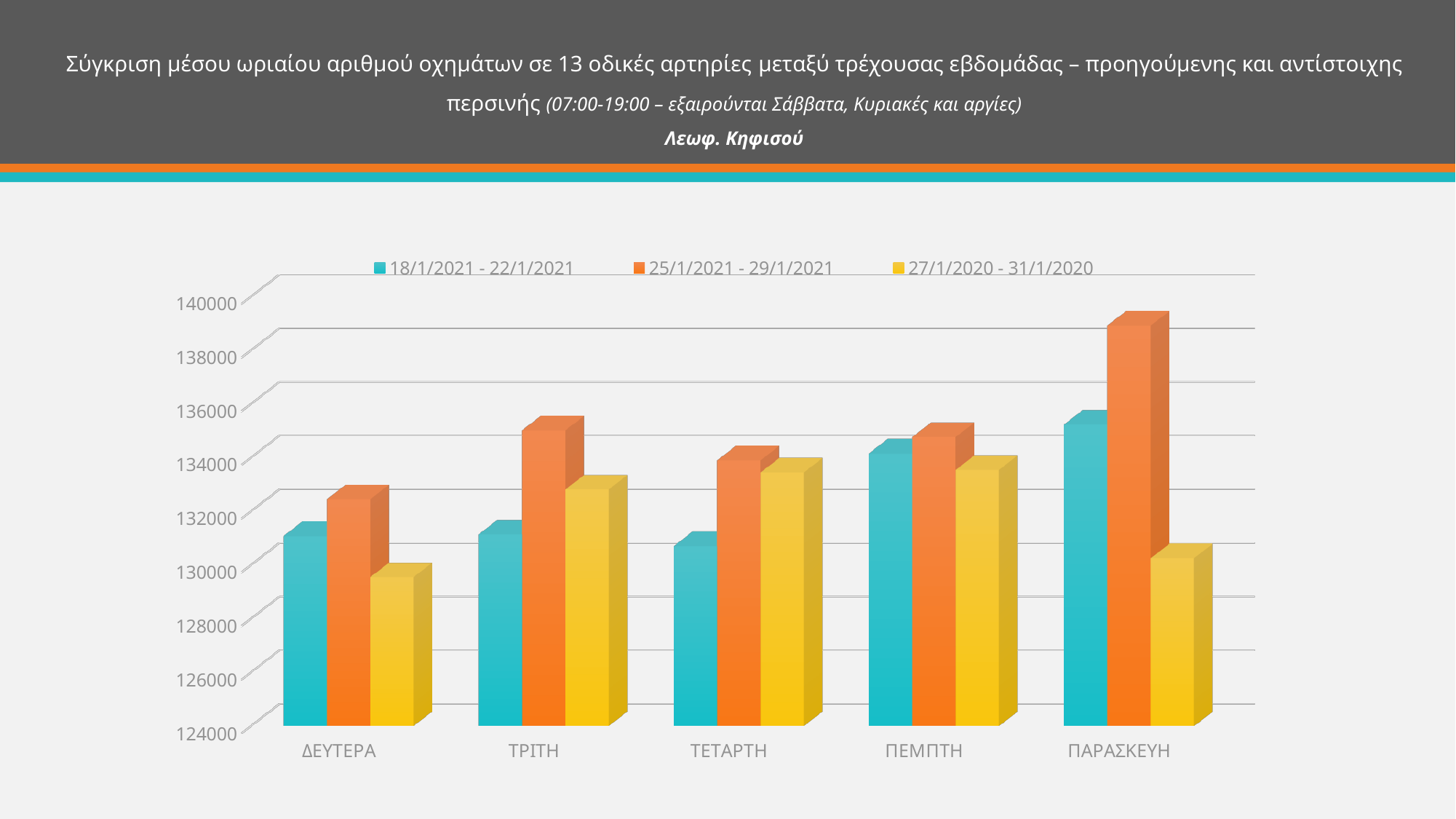
For ΠΑΡΑΣΚΕΥΗ, which is larger: the 25/1/2021 - 29/1/2021 value or the 27/1/2020 - 31/1/2020 value? 25/1/2021 - 29/1/2021 For ΔΕΥΤΕΡΑ, which is larger: the 18/1/2021 - 22/1/2021 value or the 27/1/2020 - 31/1/2020 value? 18/1/2021 - 22/1/2021 For which day is the 25/1/2021 - 29/1/2021 value highest? ΠΑΡΑΣΚΕΥΗ Is the 18/1/2021 - 22/1/2021 value for ΤΕΤΑΡΤΗ greater or less than 132000? less Which road is named in the bold subtitle above the chart? Λεωφ. Κηφισού What kind of chart is shown on the slide? bar chart Is the 27/1/2020 - 31/1/2020 value for ΠΑΡΑΣΚΕΥΗ greater or less than 132000? less For which day is the 27/1/2020 - 31/1/2020 value lowest? ΔΕΥΤΕΡΑ Is the 25/1/2021 - 29/1/2021 value for ΠΑΡΑΣΚΕΥΗ greater or less than 138000? greater How many series does the legend list? 3 How many categories (days) are shown on the x axis? 5